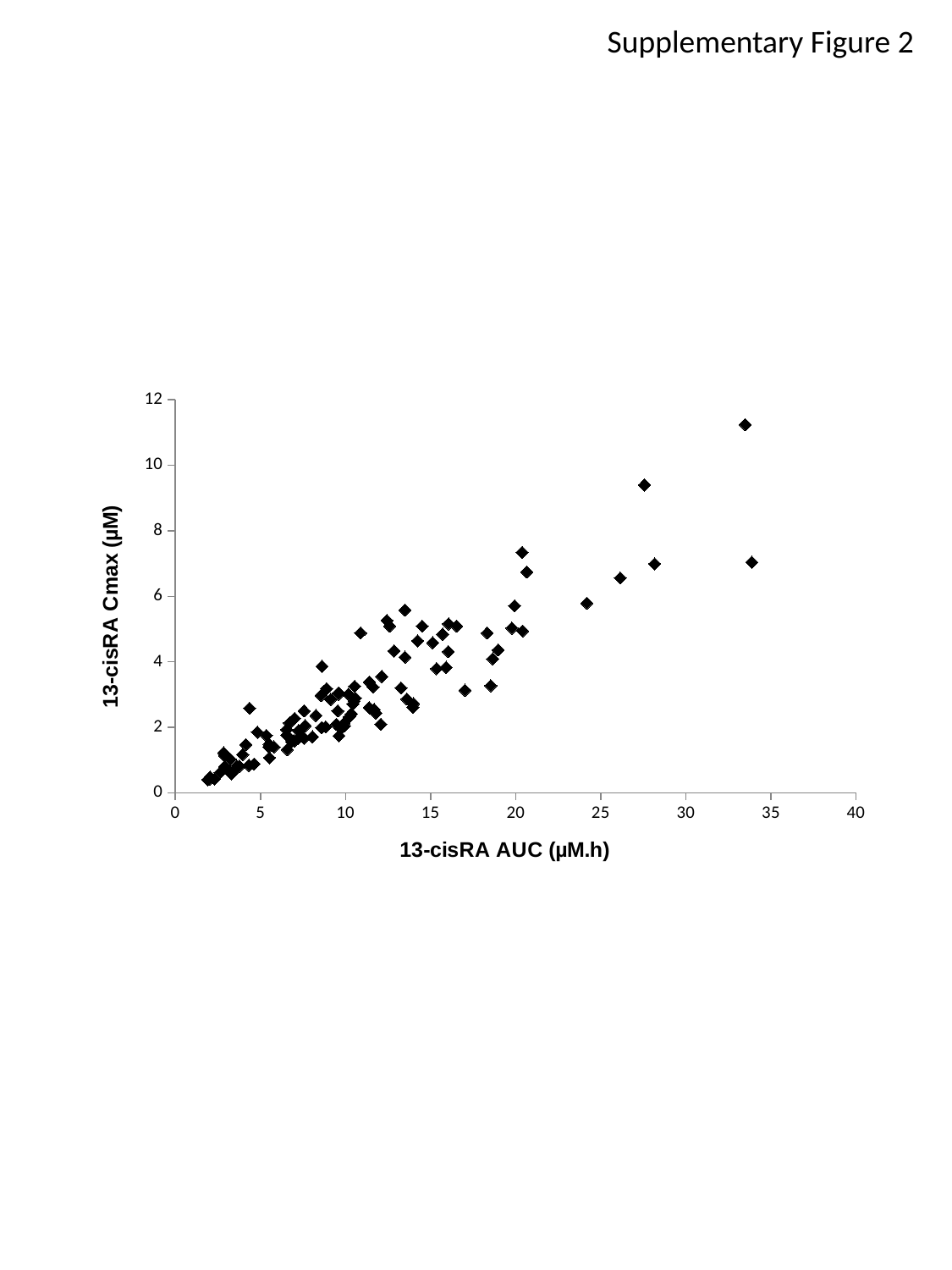
Is the highest 13-cisRA Cmax value plotted greater or less than 12? less Is the smallest 13-cisRA AUC value plotted greater or less than 5? less As 13-cisRA AUC increases along the x axis, do the 13-cisRA Cmax values generally rise or fall? rise What is the title of the x axis of the chart? 13-cisRA AUC (µM.h) Is the highest 13-cisRA Cmax value plotted greater or less than 10? greater What kind of chart is shown on the slide? scatter plot What is the title of the y axis of the chart? 13-cisRA Cmax (µM)